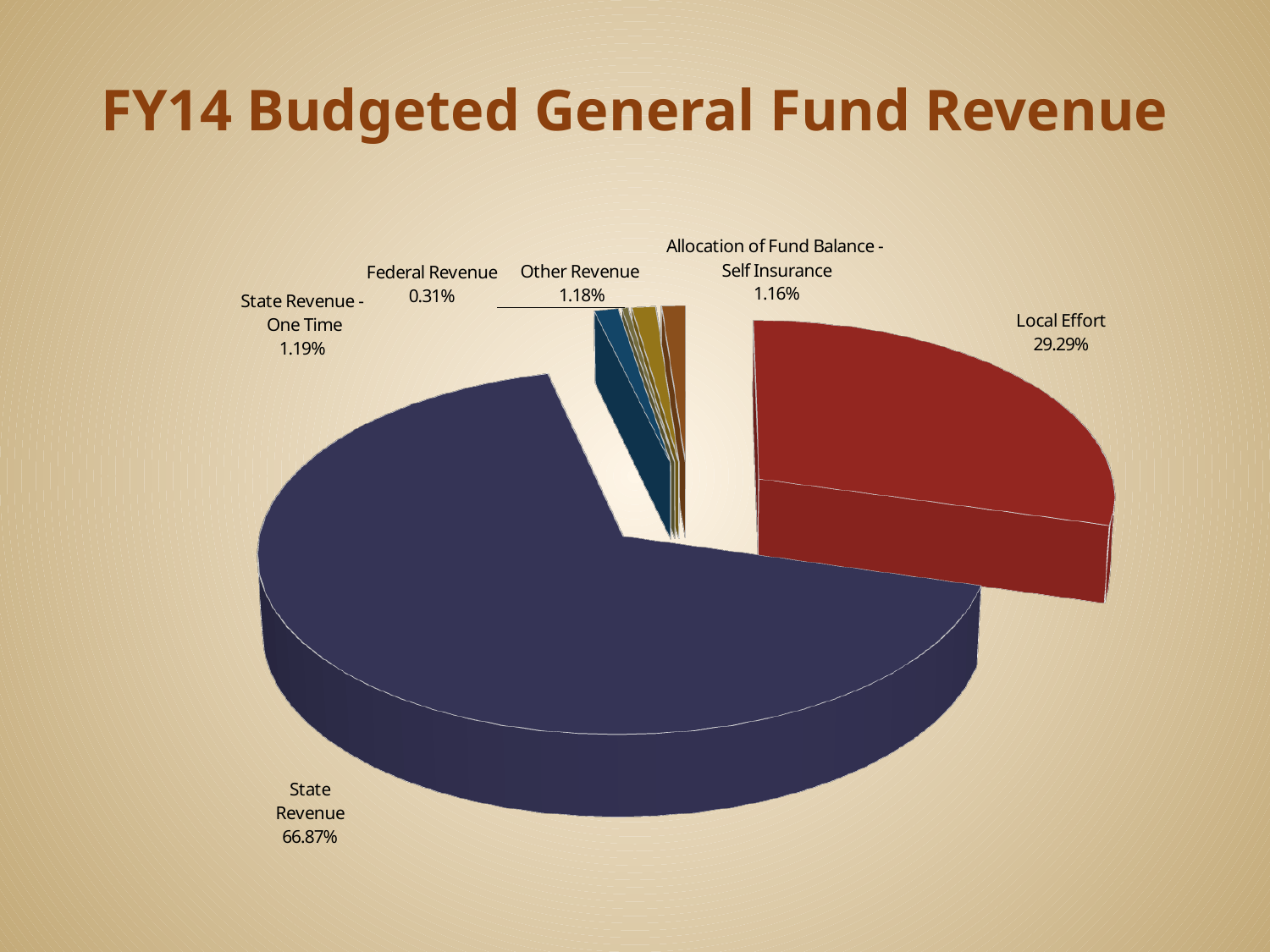
What percentage is shown for Federal Revenue? 0.31% What share of the pie is Local Effort? 29.29% What is the title of the chart? FY14 Budgeted General Fund Revenue What is the difference in percentage points between State Revenue and Local Effort? 37.58 Which category has the largest share of the pie? State Revenue What percentage is shown for Other Revenue? 1.18% How many slices does the pie chart have? 6 What percentage is shown for Allocation of Fund Balance - Self Insurance? 1.16% Which category has the smallest share of the pie? Federal Revenue What share of the pie is State Revenue? 66.87% What percentage is shown for State Revenue - One Time? 1.19% What kind of chart is shown on the slide? Pie chart